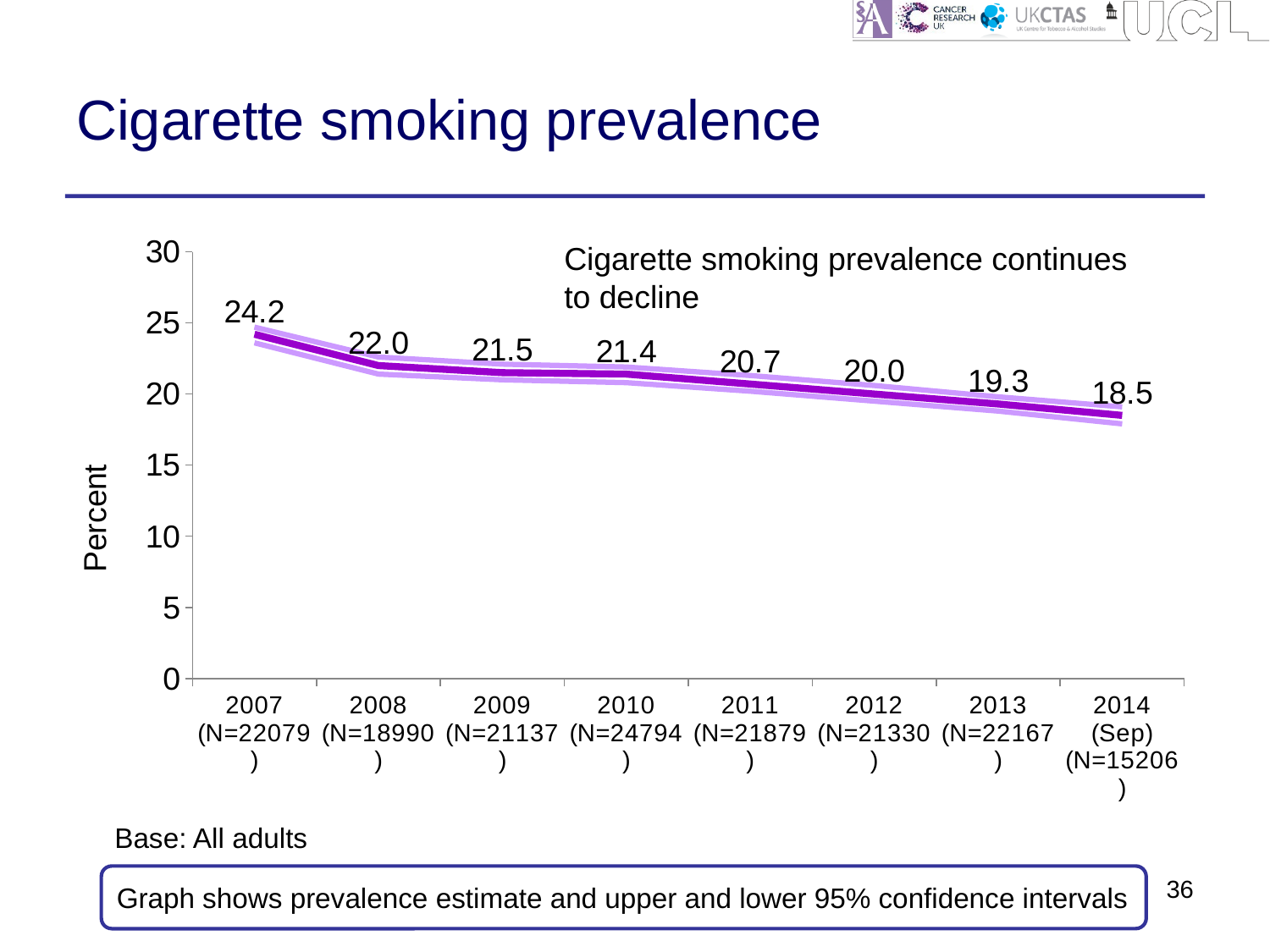
What is the difference in prevalence between 2008 and 2012? 2.0 What kind of chart is shown on the slide? Line chart Does cigarette smoking prevalence rise or fall from 2007 to 2014? Fall What is the cigarette smoking prevalence for 2014 (Sep)? 18.5 What is the label on the y axis of the chart? Percent Which year has a higher prevalence, 2009 or 2013? 2009 How many years are plotted on the x axis? 8 What is the cigarette smoking prevalence for 2011? 20.7 Which year has the highest cigarette smoking prevalence? 2007 Which year has the lowest cigarette smoking prevalence? 2014 (Sep) What is the cigarette smoking prevalence for 2007? 24.2 What is the difference in prevalence between 2007 and 2014 (Sep)? 5.7